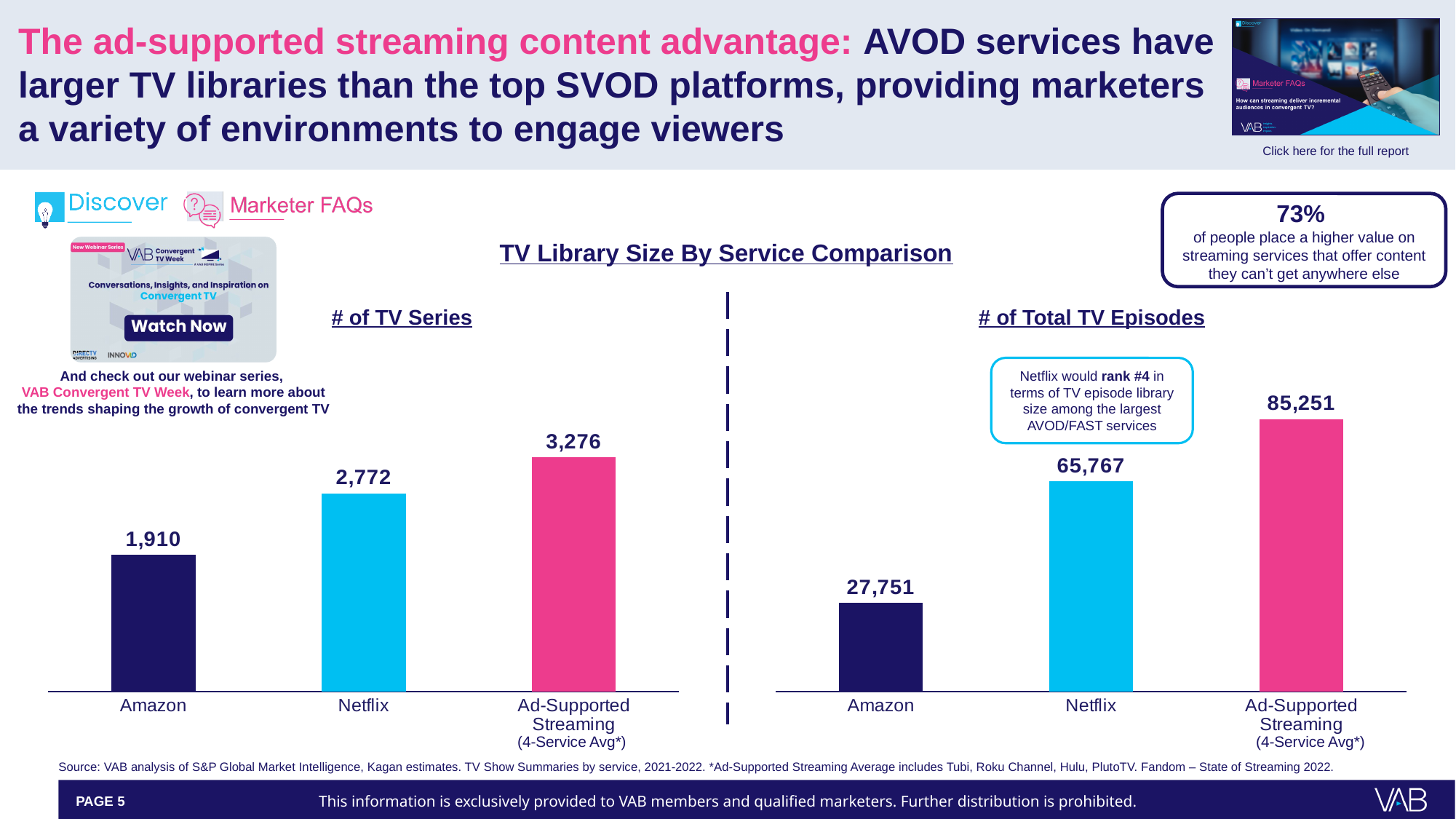
In the '# of Total TV Episodes' chart, which is larger, the value for Netflix or the value for Ad-Supported Streaming? Ad-Supported Streaming In the '# of Total TV Episodes' chart, what is the value for Amazon? 27,751 In the '# of TV Series' chart, which category has the highest value? Ad-Supported Streaming (4-Service Avg*) In the '# of TV Series' chart, what is the value for Amazon? 1,910 What kind of chart is the '# of Total TV Episodes' chart? Bar chart In the '# of Total TV Episodes' chart, what is the value for Ad-Supported Streaming (4-Service Avg*)? 85,251 How many categories are shown in the '# of TV Series' chart? 3 In the '# of Total TV Episodes' chart, what is the difference between the Netflix value and the Amazon value? 38,016 In the '# of TV Series' chart, what is the value for Netflix? 2,772 In the '# of TV Series' chart, what is the difference between the Ad-Supported Streaming value and the Netflix value? 504 What is the overall title shown above the two charts? TV Library Size By Service Comparison In the '# of Total TV Episodes' chart, which category has the lowest value? Amazon